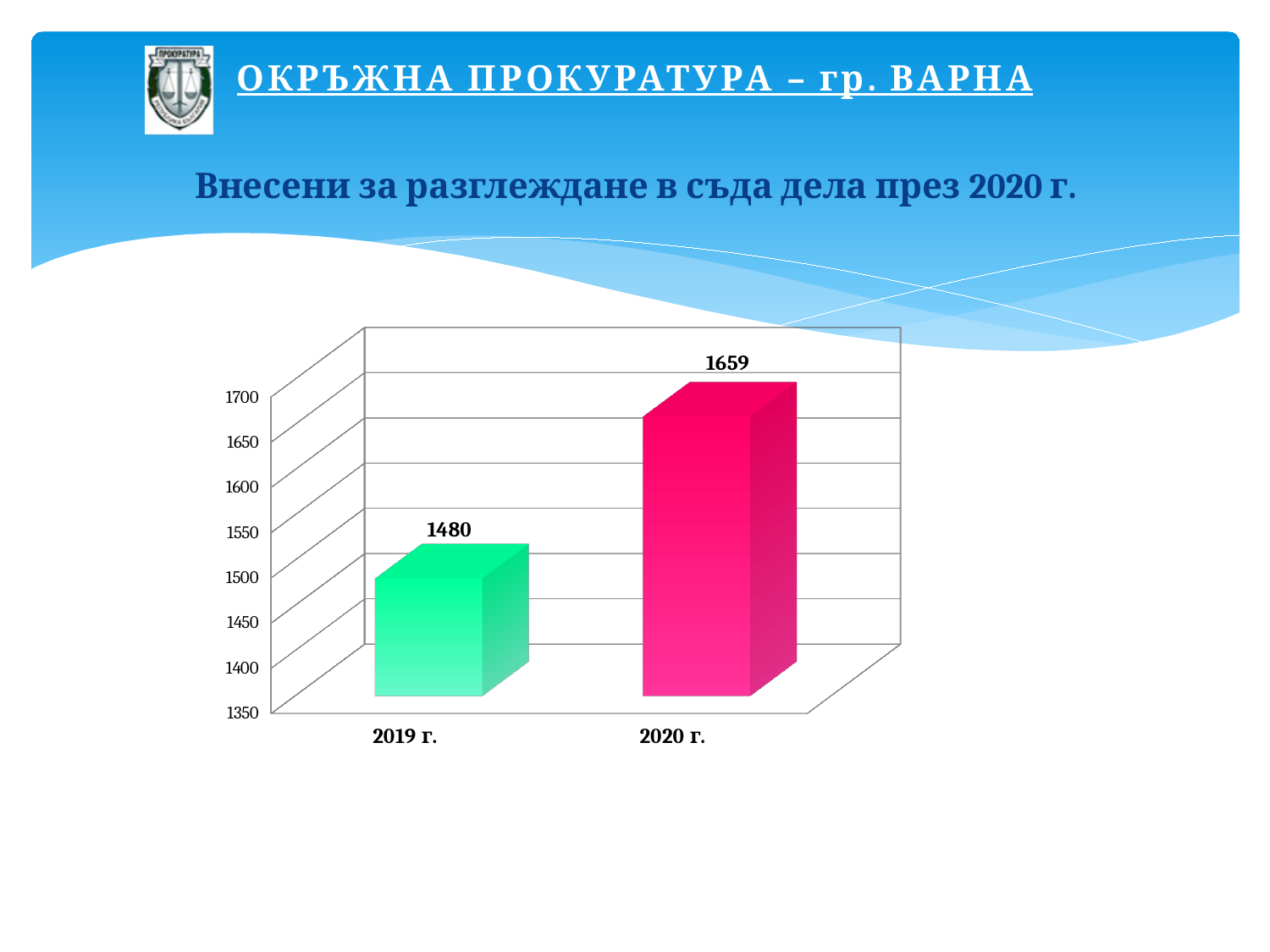
Which year has the lowest value? 2019 г. How many categories are shown on the x axis? 2 Which is larger, the value for 2019 г. or the value for 2020 г.? 2020 г. Do the values rise or fall from 2019 г. to 2020 г.? rise What is the value for 2019 г.? 1480 Is the value for 2020 г. greater or less than 1600? greater Which year has the highest value? 2020 г. What kind of chart is shown on the slide? bar chart Is the value for 2019 г. greater or less than 1500? less What colour is the bar for 2020 г.? pink What is the value for 2020 г.? 1659 What is the difference between the values for 2020 г. and 2019 г.? 179